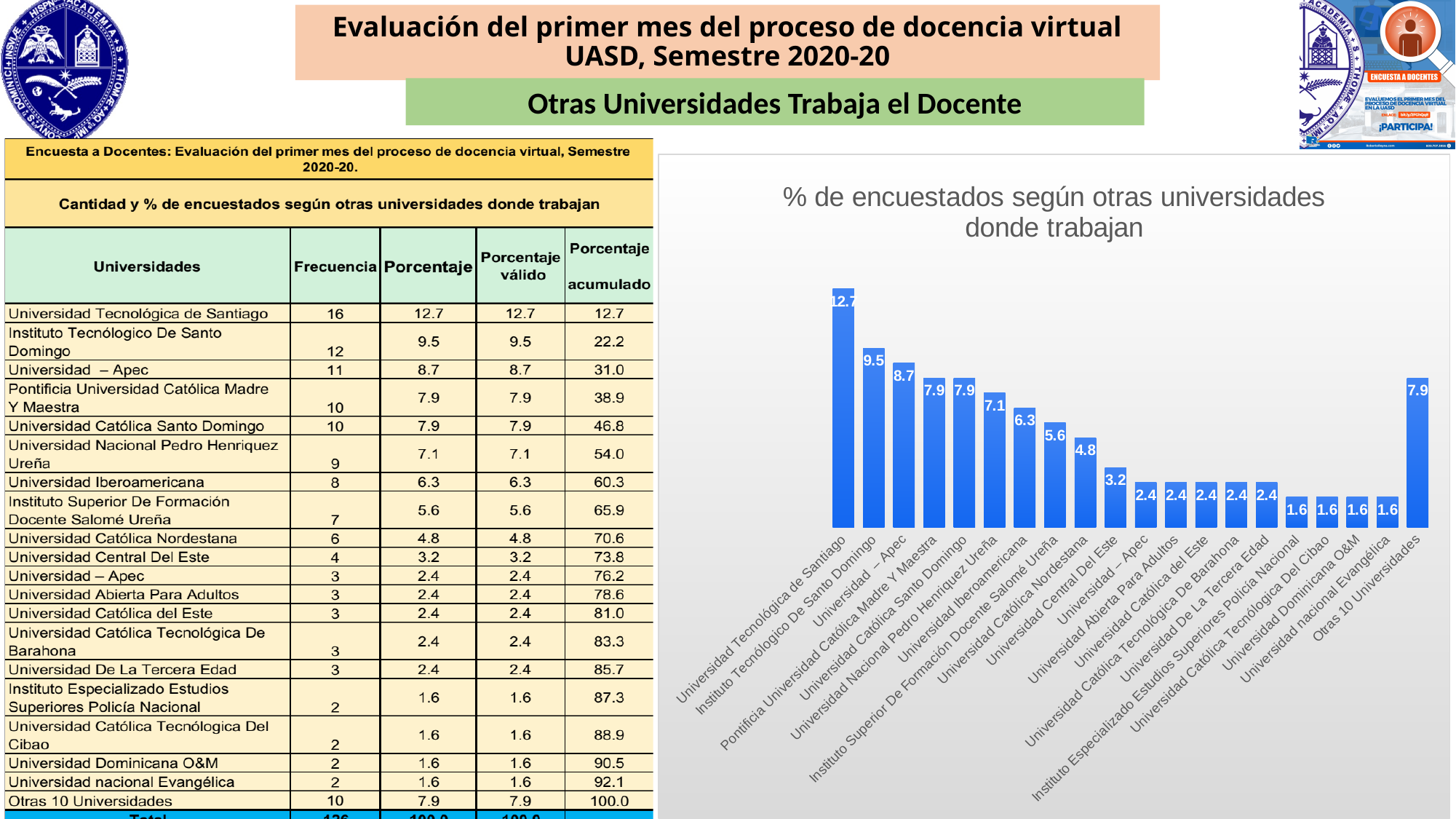
What is the title of the chart on the slide? % de encuestados según otras universidades donde trabajan What is the value for Universidad Iberoamericana in the chart? 6.3 Which university has the highest value in the chart? Universidad Tecnológica de Santiago What is the lowest value shown in the chart? 1.6 Which is larger, the value for Universidad Católica Nordestana or the value for Universidad Central Del Este? Universidad Católica Nordestana How many bars are shown in the chart? 20 What is the difference between the values for Universidad Tecnológica de Santiago and Instituto Tecnológico De Santo Domingo? 3.2 What is the value for Universidad Nacional Pedro Henríquez Ureña in the chart? 7.1 What is the value for Otras 10 Universidades in the chart? 7.9 What type of chart is shown on the slide? bar chart What is the value for Instituto Tecnológico De Santo Domingo in the chart? 9.5 What is the value for Universidad Tecnológica de Santiago in the chart? 12.7